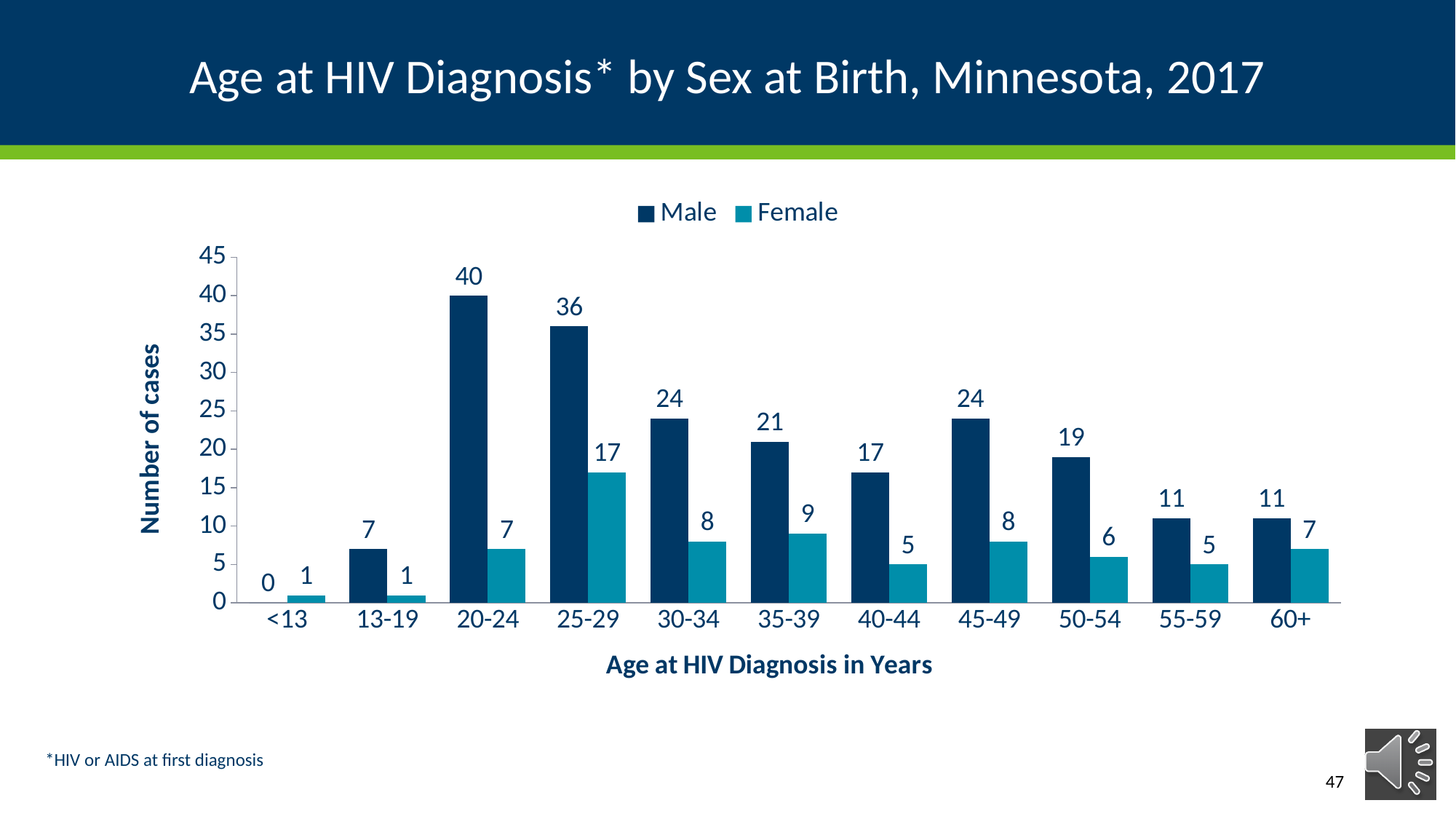
Which is larger, the number of Male cases in the 30-34 age group or in the 45-49 age group? They are equal (24) Which age group has the highest number of Female cases? 25-29 What kind of chart is shown on the slide? Bar chart Which age group has the lowest number of Male cases? <13 What is the number of Male cases in the 50-54 age group? 19 How many age groups are shown on the x axis? 11 How many series does the legend list? 2 What is the number of Male cases in the 20-24 age group? 40 What is the number of Female cases in the 25-29 age group? 17 What is the difference between Male and Female cases in the 20-24 age group? 33 Which is larger, the number of Female cases in the 35-39 age group or in the 40-44 age group? 35-39 Which age group has the highest number of Male cases? 20-24